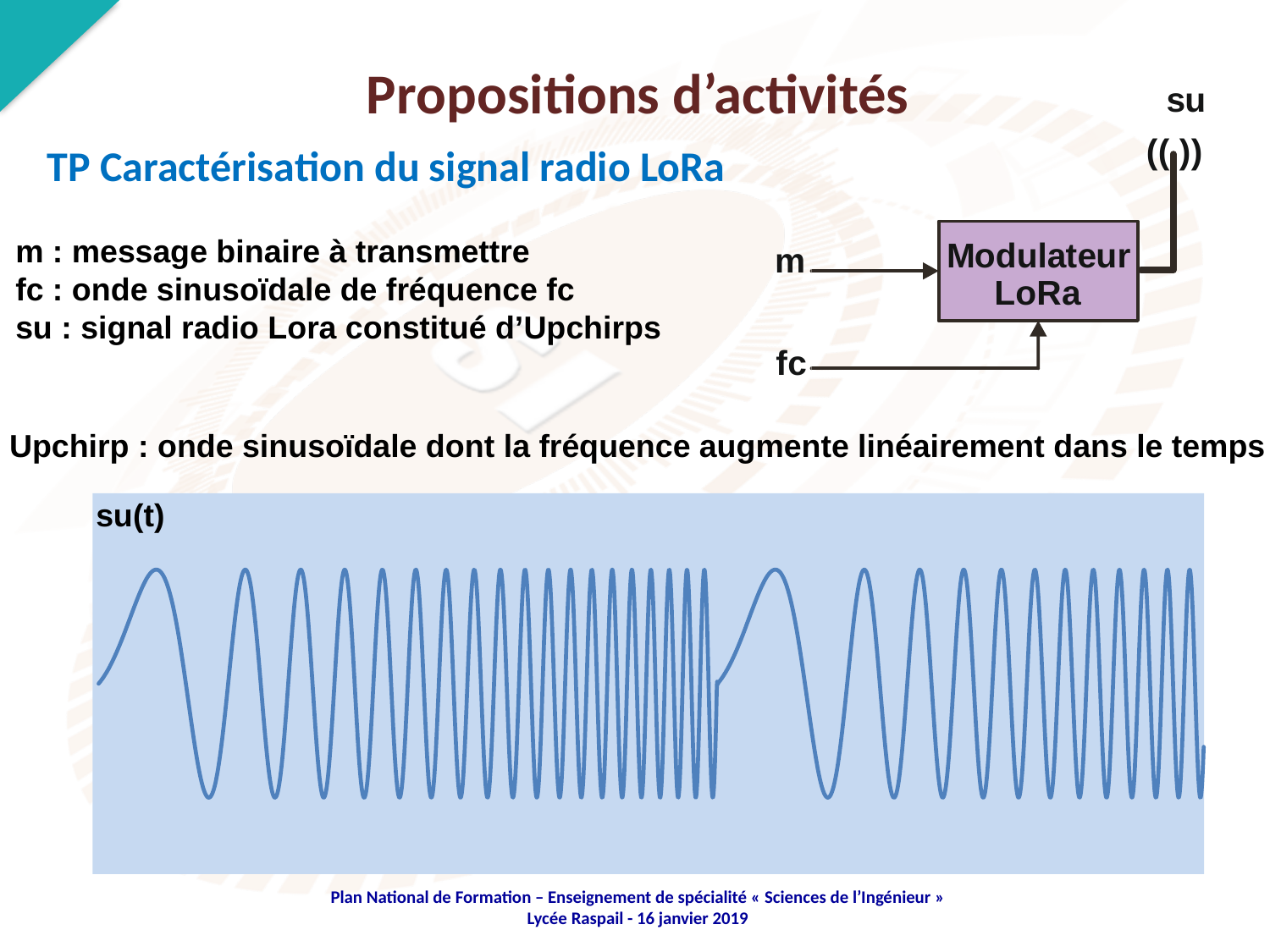
Within each upchirp in the su(t) chart, does the frequency of the oscillation increase or decrease along the x axis? increase In the su(t) chart, does the peak amplitude of the oscillations rise, fall, or stay roughly constant along the x axis? stay roughly constant What colour is the waveform line in the su(t) chart? blue What kind of chart is the su(t) plot at the bottom of the slide? line chart How many data series are plotted in the su(t) chart? 1 How many upchirps (segments where the oscillation frequency restarts low and increases) are visible in the su(t) chart? 2 What label is shown in the top-left corner of the waveform chart? su(t)